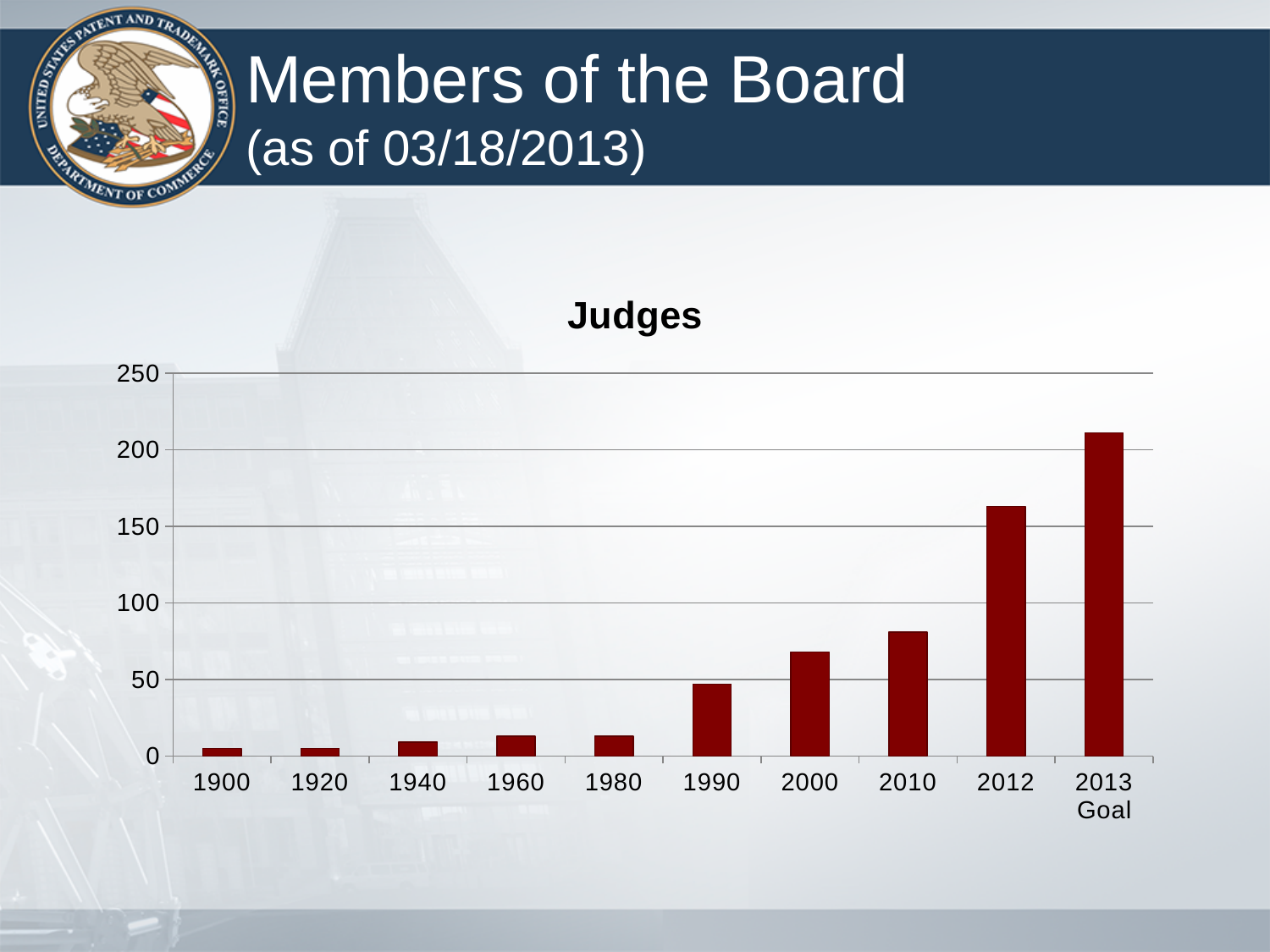
Is the value for 1980 greater or less than 50? less What kind of chart is shown on the slide? bar chart How many categories are shown on the x axis of the chart? 10 Is the value for 2010 greater or less than 100? less What colour are the bars in the chart? dark red Is the value for 2013 Goal greater or less than 200? greater What is the title of the chart? Judges Which is larger, the value for 2010 or the value for 2012? 2012 Which category has the highest value in the chart? 2013 Goal Do the values generally rise or fall from 1900 to 2013 Goal? rise